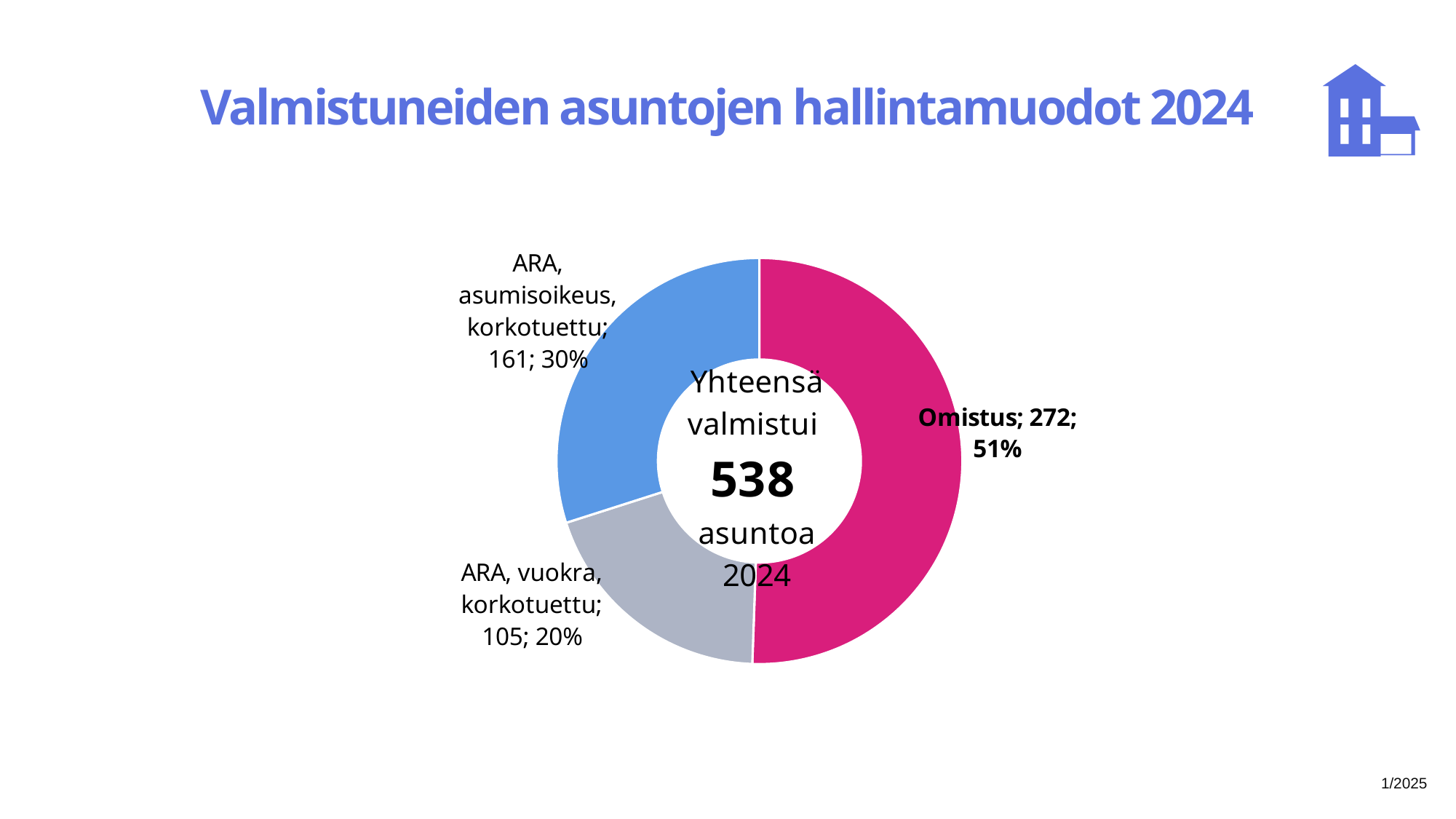
What kind of chart is shown on the slide? Doughnut (pie) chart Which category has the largest share? Omistus What is the difference between the values for Omistus and ARA, vuokra, korkotuettu? 167 Which is larger, the value for ARA, asumisoikeus, korkotuettu or ARA, vuokra, korkotuettu? ARA, asumisoikeus, korkotuettu What is the value for ARA, vuokra, korkotuettu? 105 Which category has the smallest share? ARA, vuokra, korkotuettu What share of the chart does Omistus represent? 51% How many categories does the chart show? 3 What is the value for Omistus? 272 What share of the chart does ARA, asumisoikeus, korkotuettu represent? 30% What total number of completed dwellings is shown in the centre of the chart? 538 What is the value for ARA, asumisoikeus, korkotuettu? 161